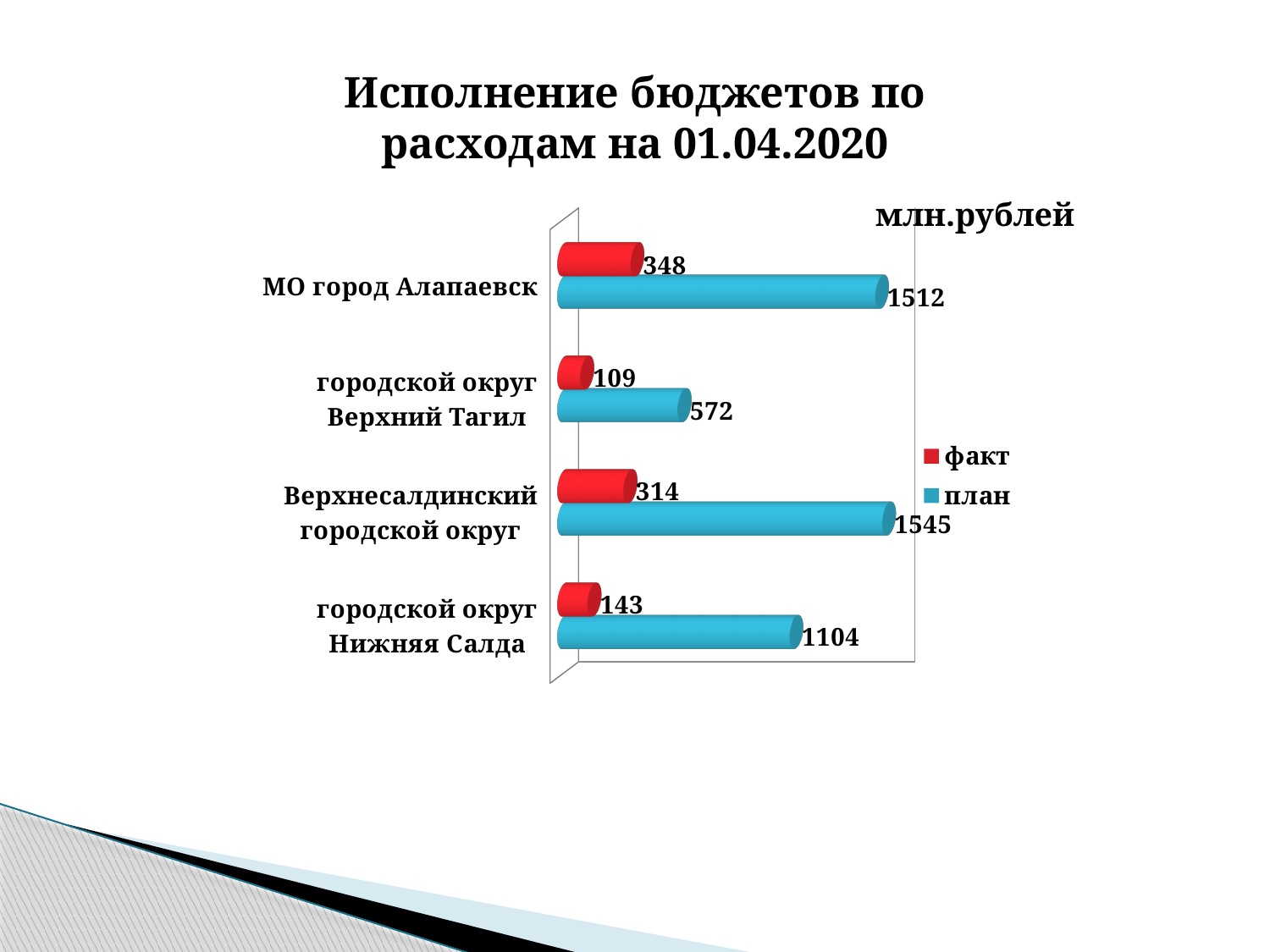
What kind of chart is shown on the slide? bar chart How many series does the legend list? 2 What unit is indicated for the values on the chart? млн.рублей What is the план value for Верхнесалдинский городской округ? 1545 Which category has the lowest факт value? городской округ Верхний Тагил What is the план value for МО город Алапаевск? 1512 How many categories are shown on the chart? 4 What is the факт value for городской округ Нижняя Салда? 143 Which is larger: the факт value for Верхнесалдинский городской округ or the факт value for МО город Алапаевск? МО город Алапаевск Which category has the highest план value? Верхнесалдинский городской округ What is the difference between the план and факт values for МО город Алапаевск? 1164 What is the факт value for городской округ Верхний Тагил? 109